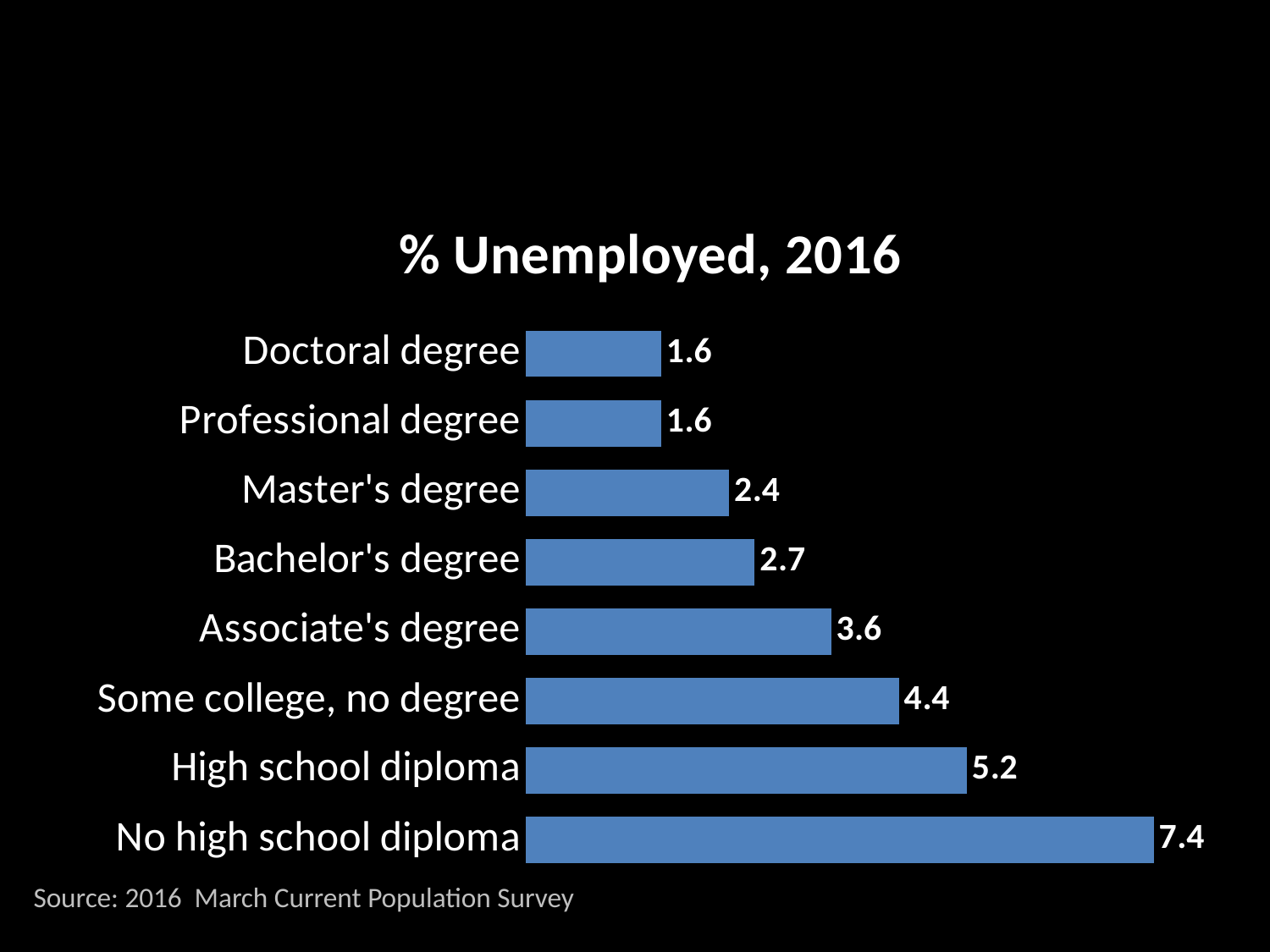
What is the title of the chart? % Unemployed, 2016 What is the value shown for 'High school diploma'? 5.2 Do the values increase or decrease going from 'Doctoral degree' at the top to 'No high school diploma' at the bottom? Increase What kind of chart is shown on the slide? Bar chart Which is larger, the value for 'Associate's degree' or the value for 'Bachelor's degree'? Associate's degree What is the difference between the values for 'No high school diploma' and 'High school diploma'? 2.2 What source is cited below the chart? 2016 March Current Population Survey How many categories are shown in the chart? 8 What is the unemployment rate for people with a Bachelor's degree? 2.7 What is the value shown for 'Some college, no degree'? 4.4 What is the difference between the values for 'Associate's degree' and 'Master's degree'? 1.2 Which category has the highest unemployment rate? No high school diploma